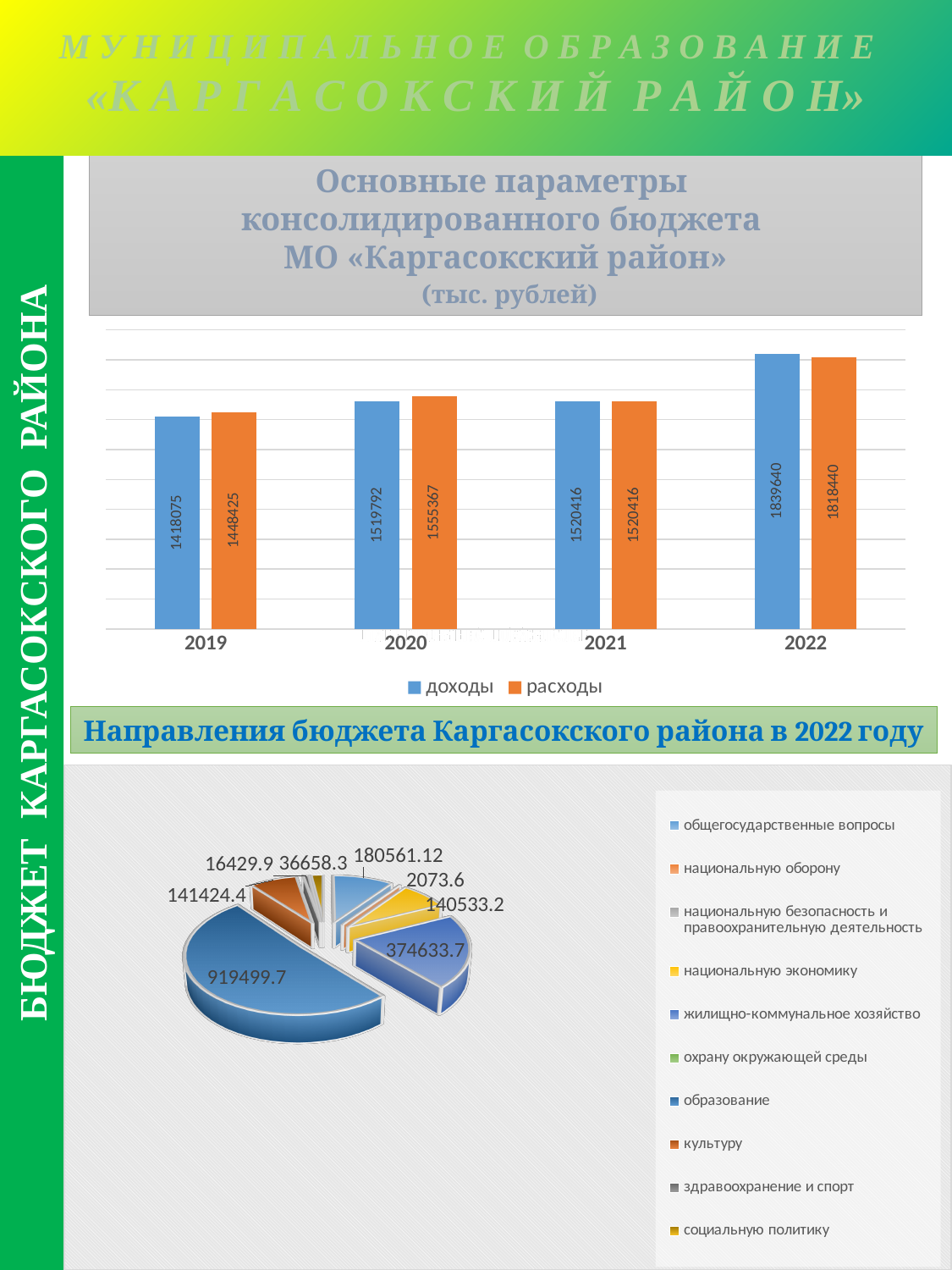
In the bar chart 'Основные параметры консолидированного бюджета', how many series does the legend list? 2 In the bar chart 'Основные параметры консолидированного бюджета', what is the difference between доходы and расходы in 2022? 21200 In the bar chart 'Основные параметры консолидированного бюджета', which year has the lowest расходы? 2019 In the bar chart 'Основные параметры консолидированного бюджета', which year has the highest доходы? 2022 What kind of chart is the lower chart 'Направления бюджета Каргасокского района в 2022 году'? pie chart In the bar chart 'Основные параметры консолидированного бюджета', which is larger in 2020, доходы or расходы? расходы In the bar chart 'Основные параметры консолидированного бюджета', what is the value of доходы for 2022? 1839640 In the bar chart 'Основные параметры консолидированного бюджета', do the доходы values rise or fall from 2019 to 2022? rise In the bar chart 'Основные параметры консолидированного бюджета', what is the value of расходы for 2020? 1555367 In the pie chart 'Направления бюджета Каргасокского района в 2022 году', what is the value of the largest slice? 919499.7 In the bar chart 'Основные параметры консолидированного бюджета', how many years are shown on the x axis? 4 In the bar chart 'Основные параметры консолидированного бюджета', what is the value of доходы for 2019? 1418075